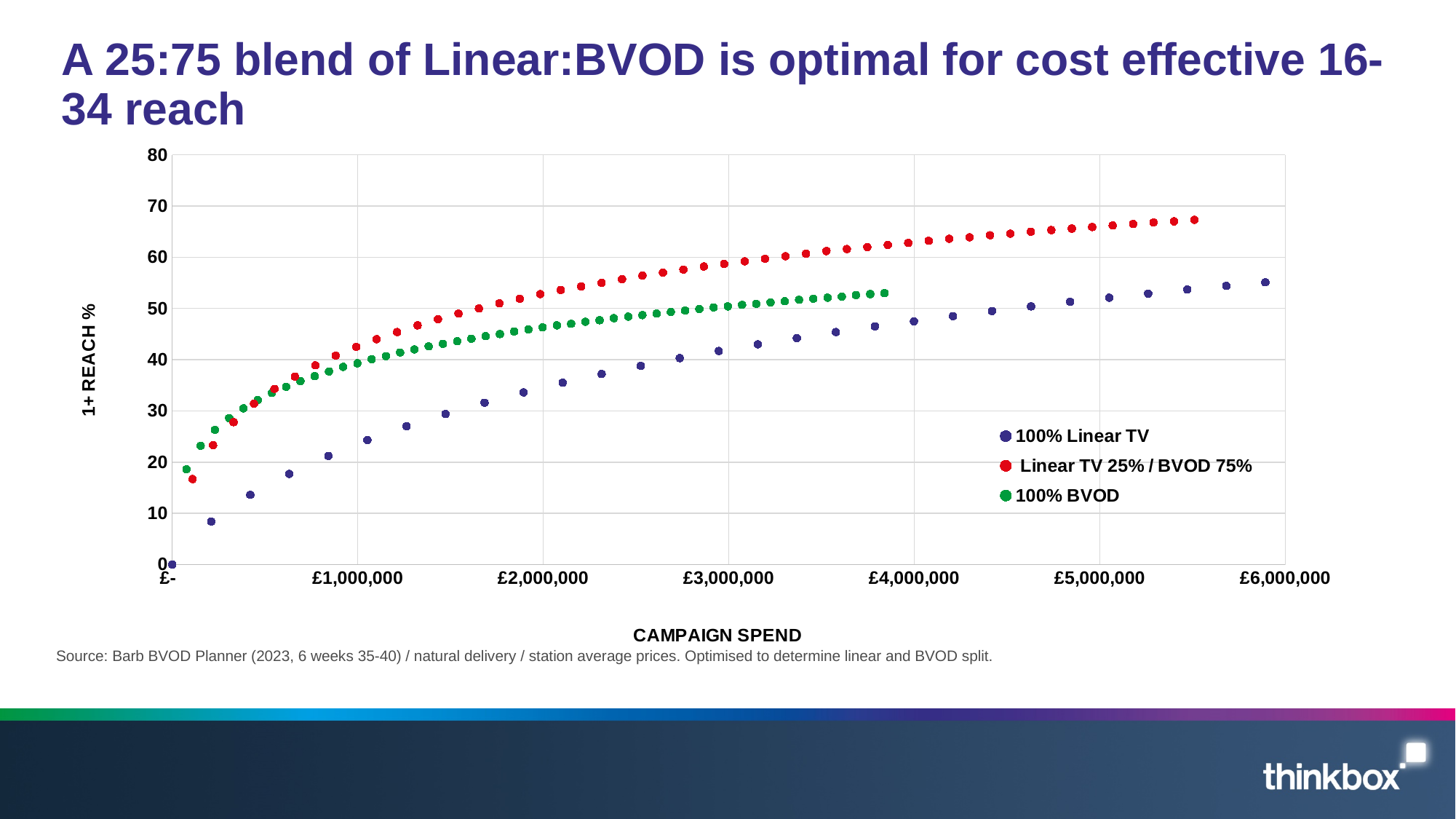
How many series does the legend list? 3 Is the highest 1+ reach % plotted for 100% Linear TV greater or less than 50? greater At a campaign spend of £1,000,000, which series has the lowest 1+ reach %? 100% Linear TV Is the 1+ reach % for Linear TV 25% / BVOD 75% at £5,000,000 spend greater or less than 60? greater Which series reaches the highest 1+ reach % on the chart? Linear TV 25% / BVOD 75% Is the 1+ reach % for 100% Linear TV at £1,000,000 spend greater or less than 30? less Do the 1+ reach % values for 100% Linear TV rise or fall as campaign spend increases? rise What is the title of the vertical axis? 1+ REACH % At a campaign spend of £3,000,000, which series has the higher 1+ reach %: 100% Linear TV or Linear TV 25% / BVOD 75%? Linear TV 25% / BVOD 75% What are the three series named in the legend? 100% Linear TV, Linear TV 25% / BVOD 75%, 100% BVOD What kind of chart is shown on the slide? scatter chart